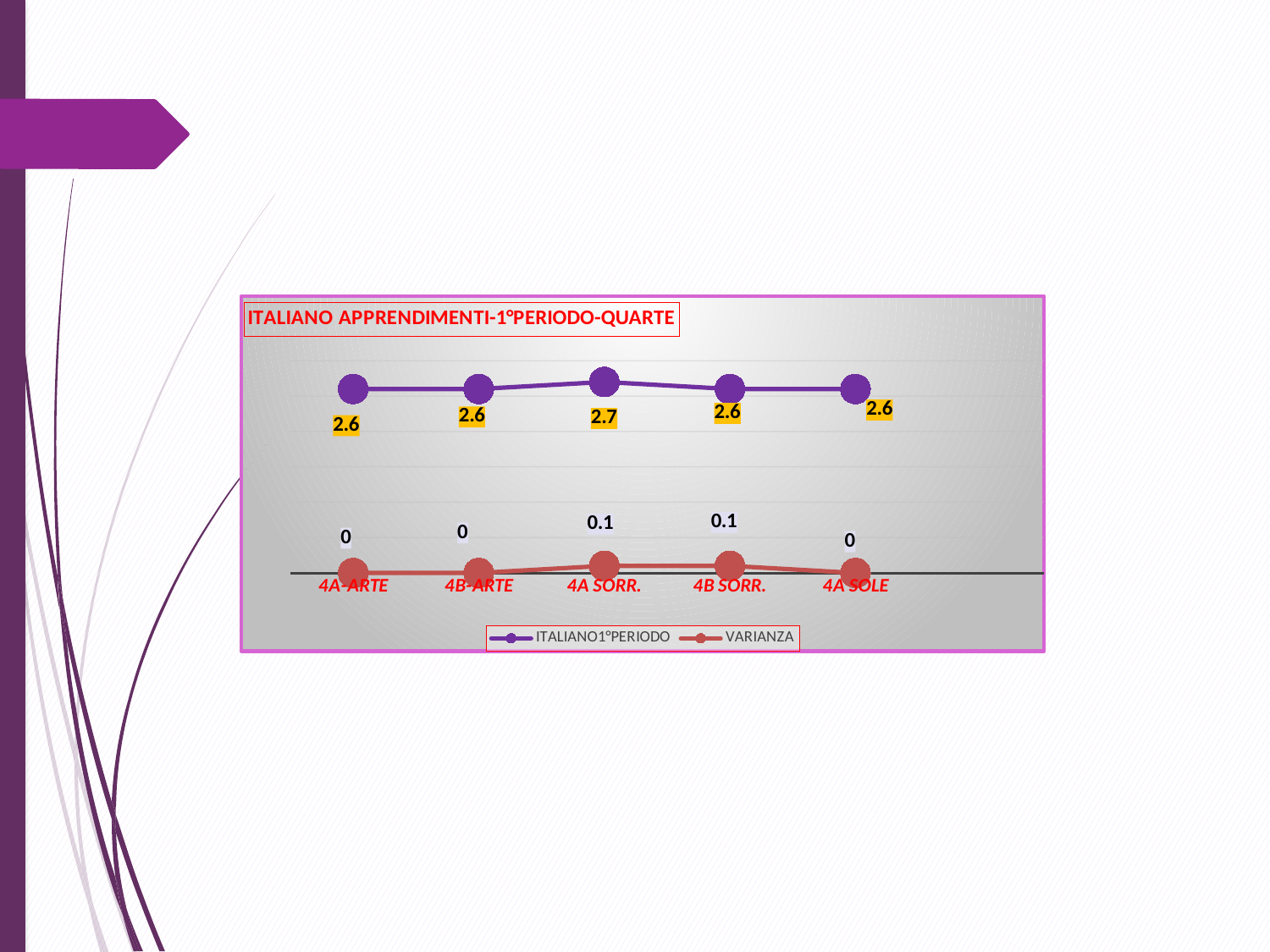
Which is larger, the VARIANZA value for 4A SORR. or for 4A ARTE? 4A SORR. What is the difference between the ITALIANO1°PERIODO values for 4A SORR. and 4A ARTE? 0.1 What kind of chart is shown on the slide? Line chart How many series does the legend list? 2 What is the title of the chart? ITALIANO APPRENDIMENTI-1°PERIODO-QUARTE What is the VARIANZA value for 4A SOLE? 0 What is the VARIANZA value for 4B SORR.? 0.1 What is the ITALIANO1°PERIODO value for 4A SORR.? 2.7 Which series is drawn in purple? ITALIANO1°PERIODO How many categories are shown on the x axis? 5 Which category has the highest ITALIANO1°PERIODO value? 4A SORR. What is the ITALIANO1°PERIODO value for 4B ARTE? 2.6